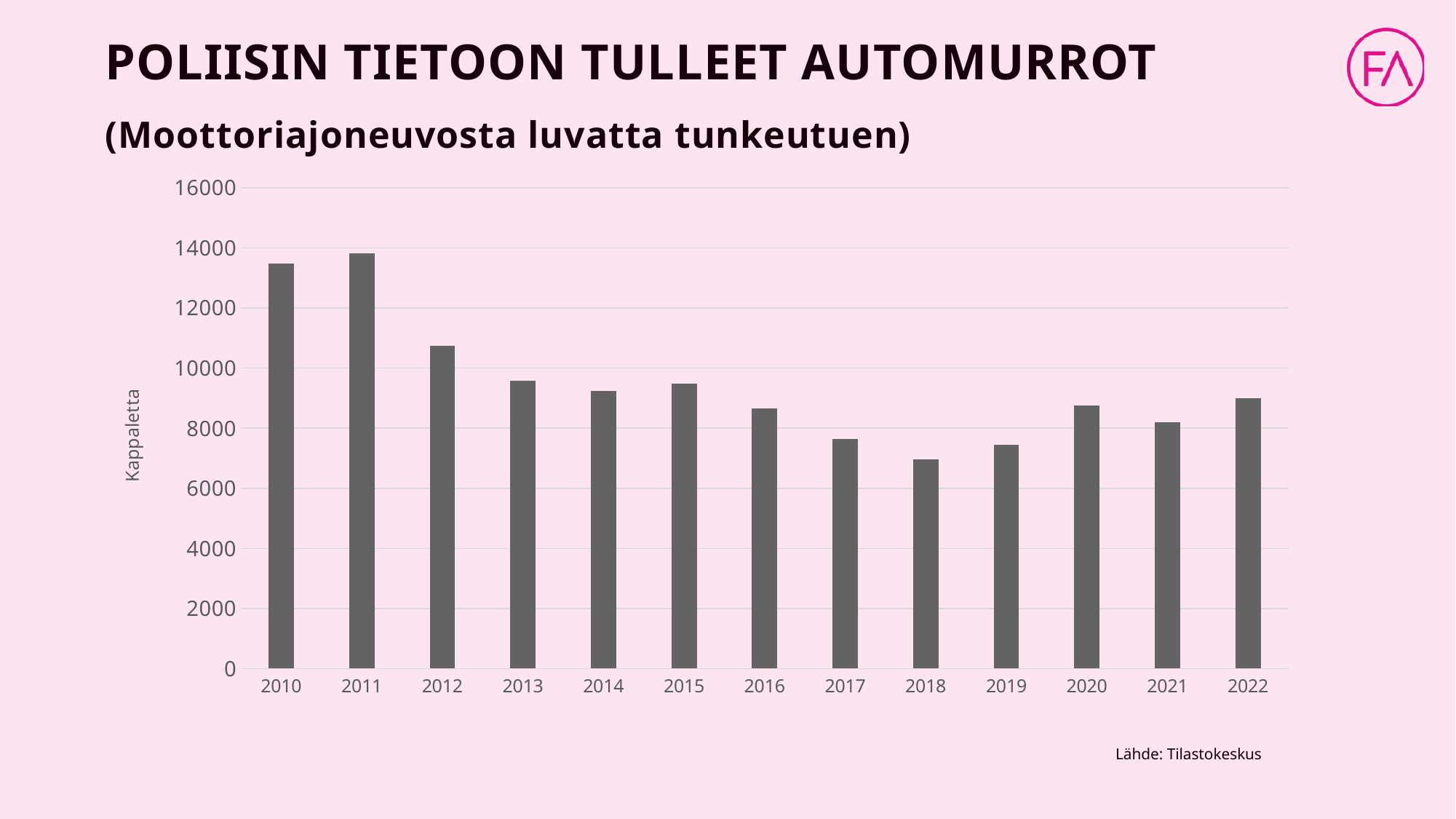
What kind of chart is shown on the slide? bar chart Which year has the lowest number of car break-ins in the chart? 2018 Is the value for 2012 greater or less than 10000? greater What is the label on the vertical axis of the chart? Kappaletta Which year has the larger value, 2012 or 2013? 2012 Is the value for 2010 greater or less than 12000? greater Is the value for 2022 greater or less than 10000? less Which year has the larger value, 2018 or 2019? 2019 How many years are shown on the x axis of the chart? 13 Which year has the highest number of car break-ins in the chart? 2011 Do the values generally rise or fall from 2010 to 2018? fall